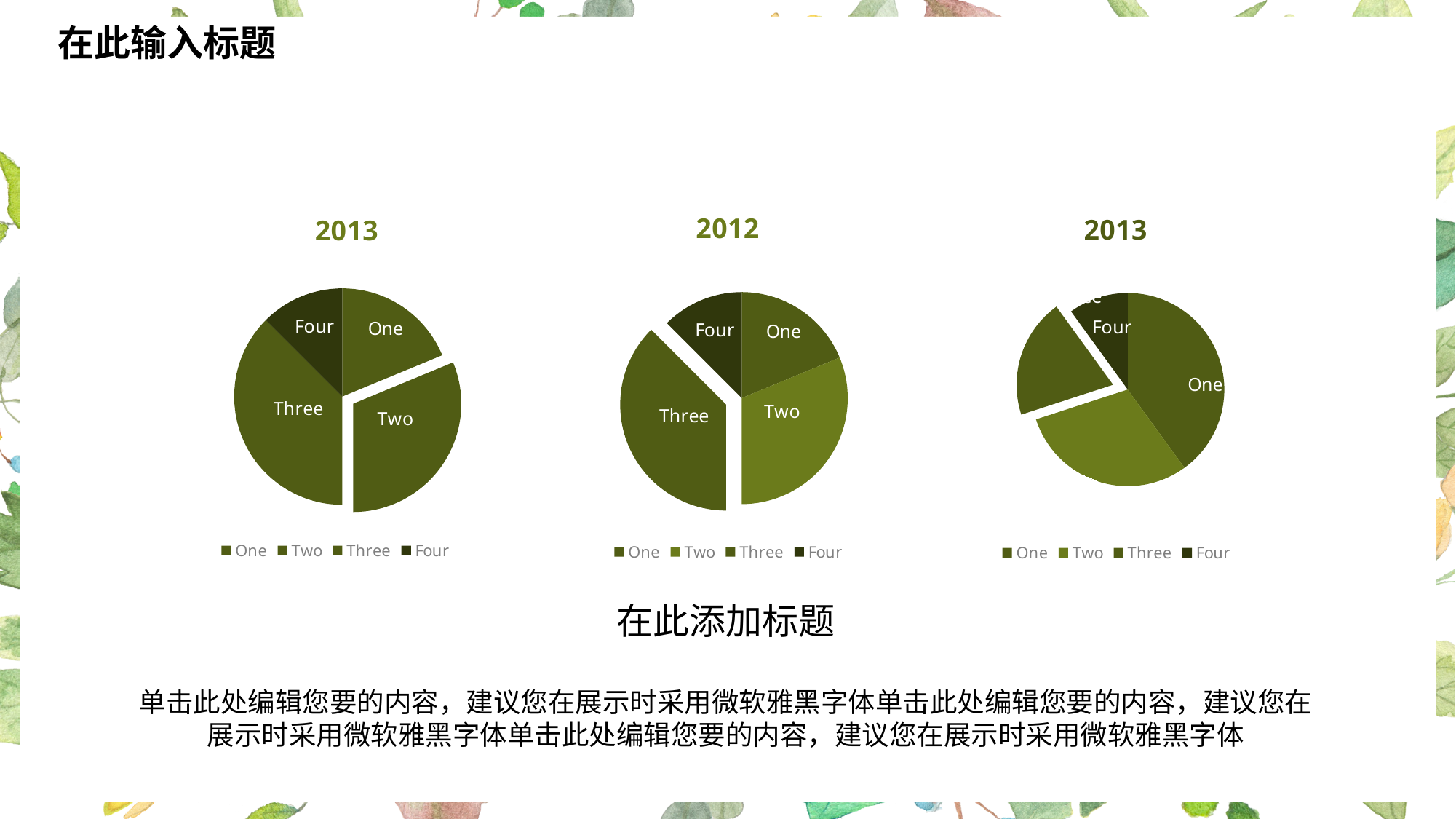
How many slices does the left-hand pie chart (2013) have? 4 In the left-hand pie chart (2013), which slice is larger, Two or Four? Two In the middle pie chart (2012), which category has the largest slice? Three What is the title of the middle chart? 2012 In the left-hand pie chart (2013), which category has the largest slice? Three In the left-hand pie chart (2013), which slice is larger, Three or One? Three In the right-hand pie chart (2013), which slice is larger, One or Four? One How many pie charts are shown on the slide? 3 What kind of chart is the left-hand chart titled 2013? pie chart In the left-hand pie chart (2013), which slice is pulled out from the rest of the pie? Two How many entries does the legend of the middle chart (2012) list? 4